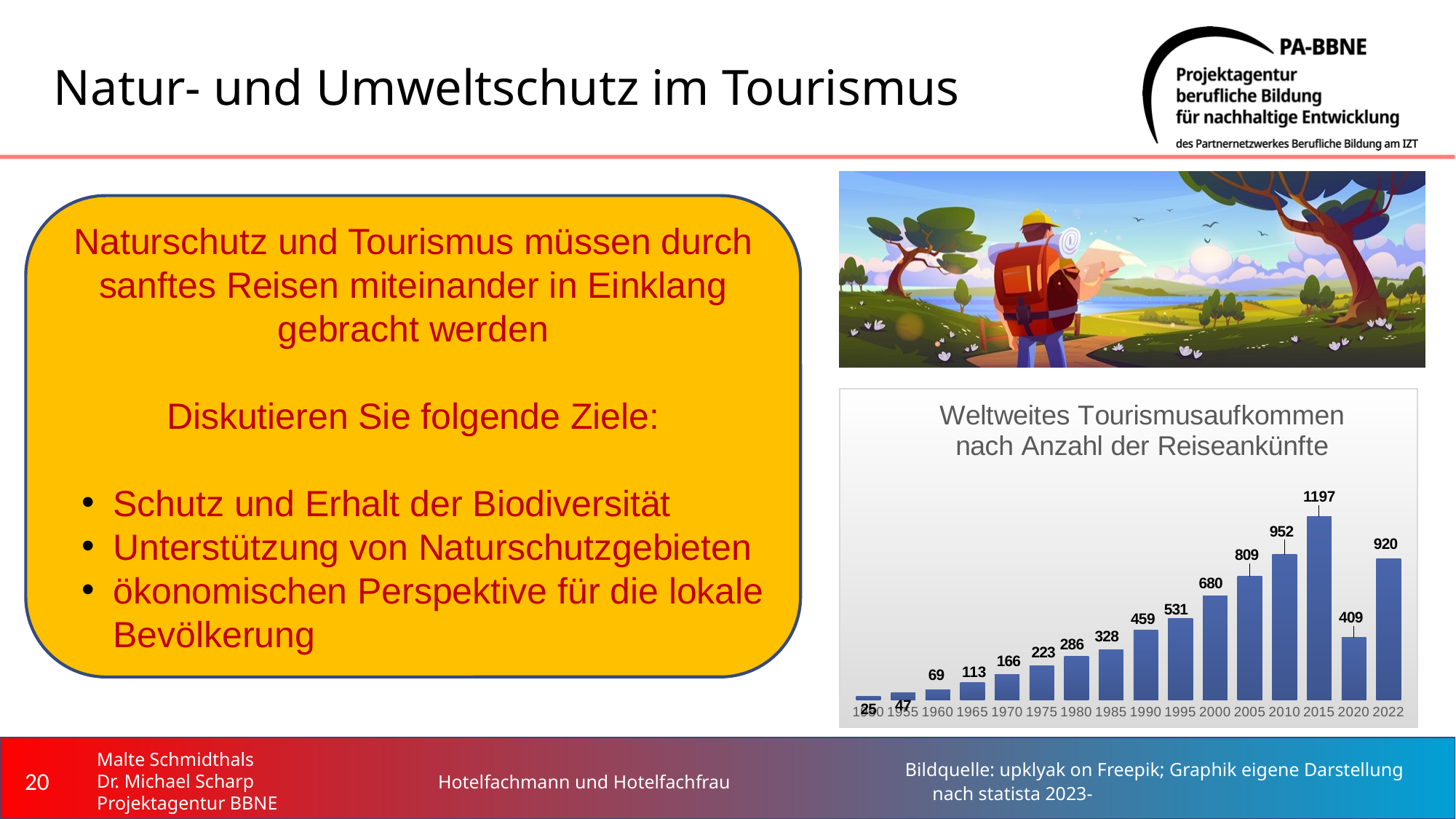
What is the difference between the values for 2022 and 2010? 32 What kind of chart is shown on the slide? Bar chart What is the difference between the values for 2015 and 2020? 788 What is the value for 2015 in the chart 'Weltweites Tourismusaufkommen nach Anzahl der Reiseankünfte'? 1197 What is the value for 1980 in the chart? 286 Which year has the highest value in the chart? 2015 What is the title of the chart on the slide? Weltweites Tourismusaufkommen nach Anzahl der Reiseankünfte Which year has the lowest value in the chart? 1950 How many years (bars) are shown in the chart? 16 What is the value for 2020 in the chart? 409 What is the value for 2000 in the chart? 680 Which is larger, the value for 2005 or the value for 2022? 2022